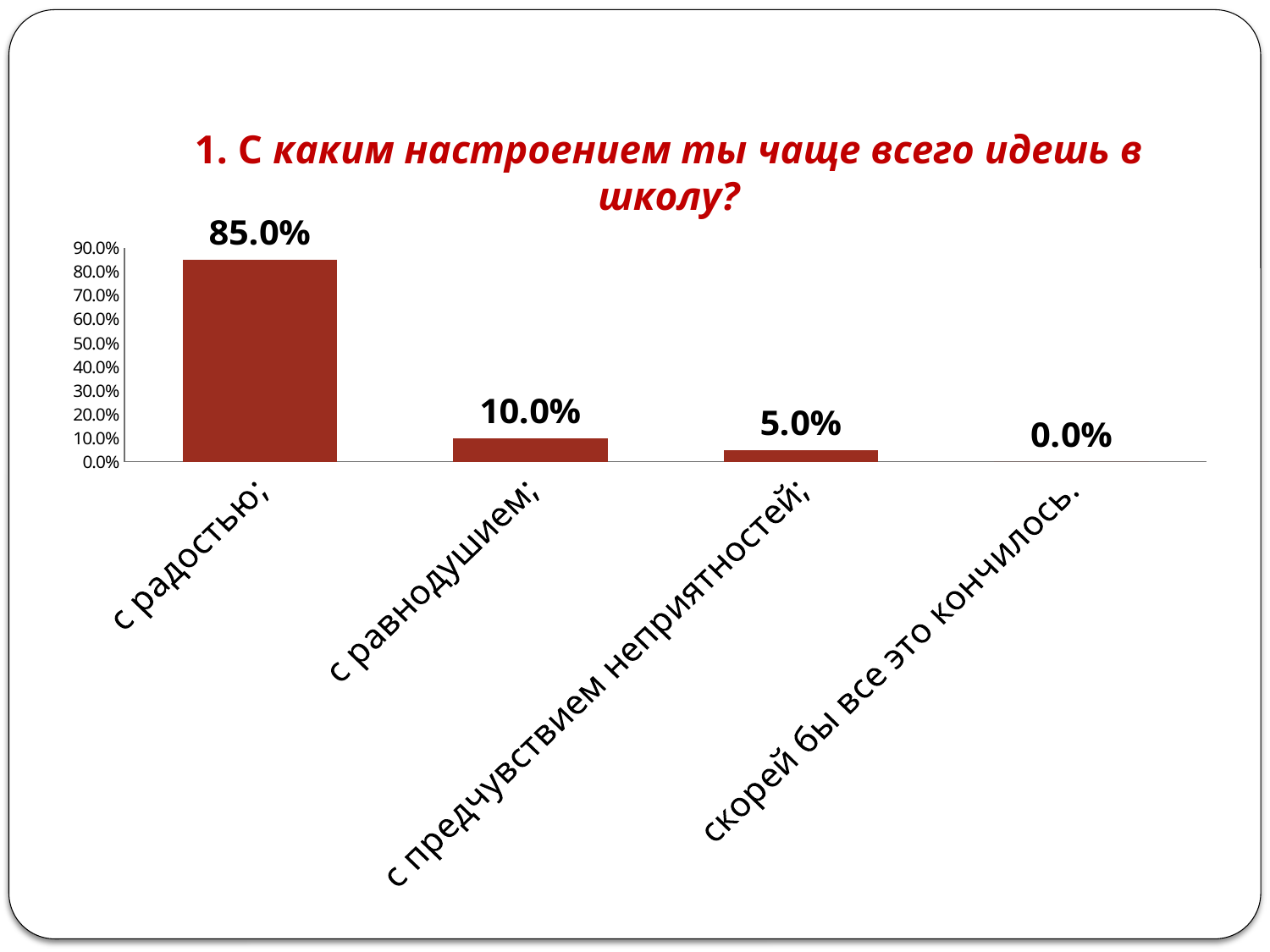
Which category has the lowest value? скорей бы все это кончилось. How many categories are shown on the chart? 4 What is the value for "с равнодушием;"? 10.0% Which is larger, the value for "с равнодушием;" or the value for "с предчувствием неприятностей;"? с равнодушием; What kind of chart is shown on the slide? bar chart What is the difference between the values for "с радостью;" and "с равнодушием;"? 75.0% Do the values rise or fall from left to right along the x axis? fall What is the difference between the values for "с равнодушием;" and "с предчувствием неприятностей;"? 5.0% What is the value for "с предчувствием неприятностей;"? 5.0% Which category has the highest value? с радостью; What is the value for "скорей бы все это кончилось."? 0.0% What is the value for "с радостью;"? 85.0%